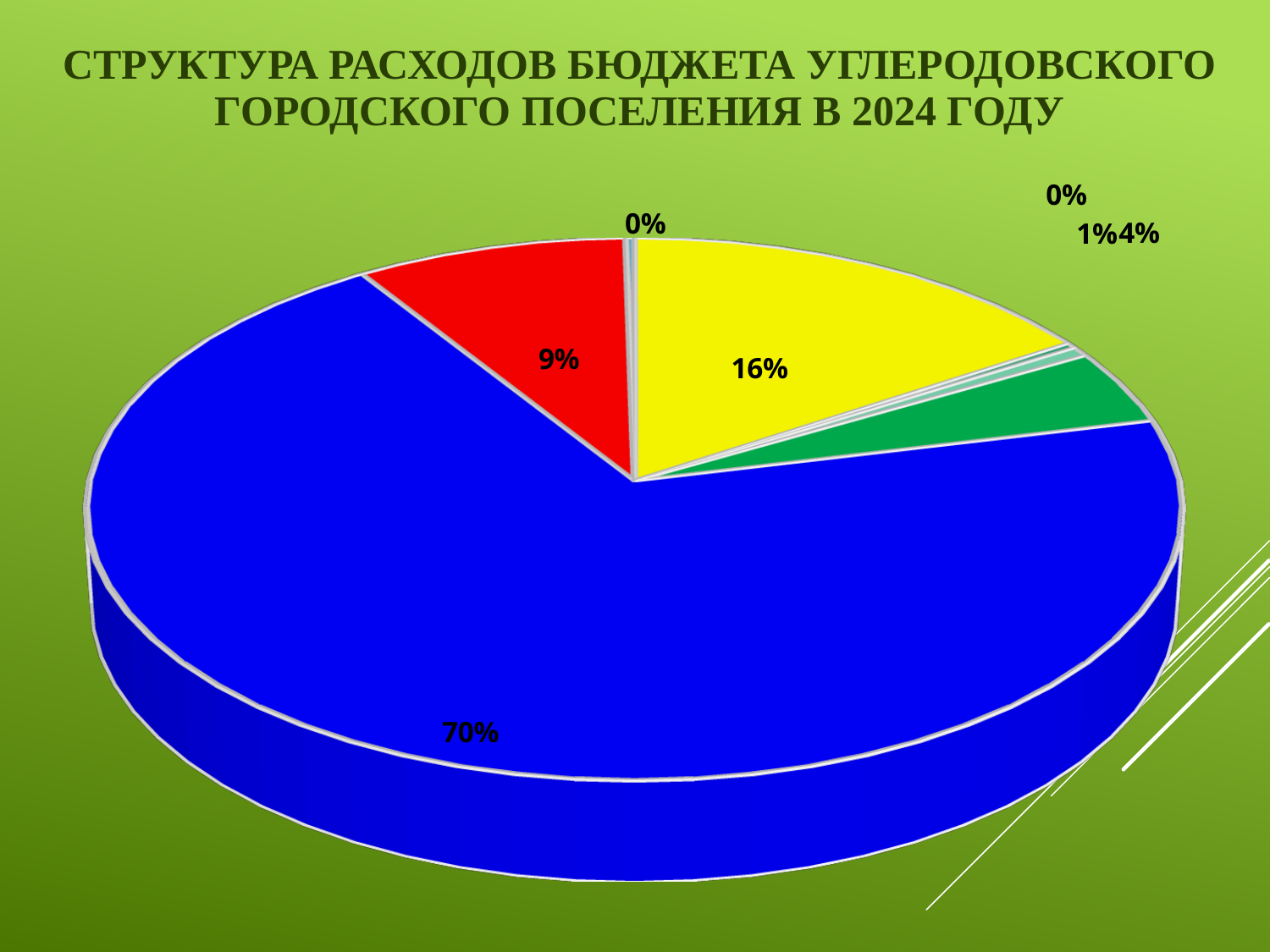
What kind of chart is shown on the slide? pie chart Which colour slice has the largest share of the pie chart? blue What is the title of the chart on the slide? СТРУКТУРА РАСХОДОВ БЮДЖЕТА УГЛЕРОДОВСКОГО ГОРОДСКОГО ПОСЕЛЕНИЯ В 2024 ГОДУ How many percentage data labels are shown on the pie chart? 7 What percentage is shown for the yellow slice of the pie chart? 16% What is the difference in percentage points between the blue slice and the yellow slice? 54 Which is larger, the yellow slice or the red slice? yellow What percentage is shown for the blue slice of the pie chart? 70% What percentage is shown for the green slice of the pie chart? 4% What is the difference in percentage points between the red slice and the green slice? 5 What percentage is shown for the red slice of the pie chart? 9% Does the pie chart include a legend? No